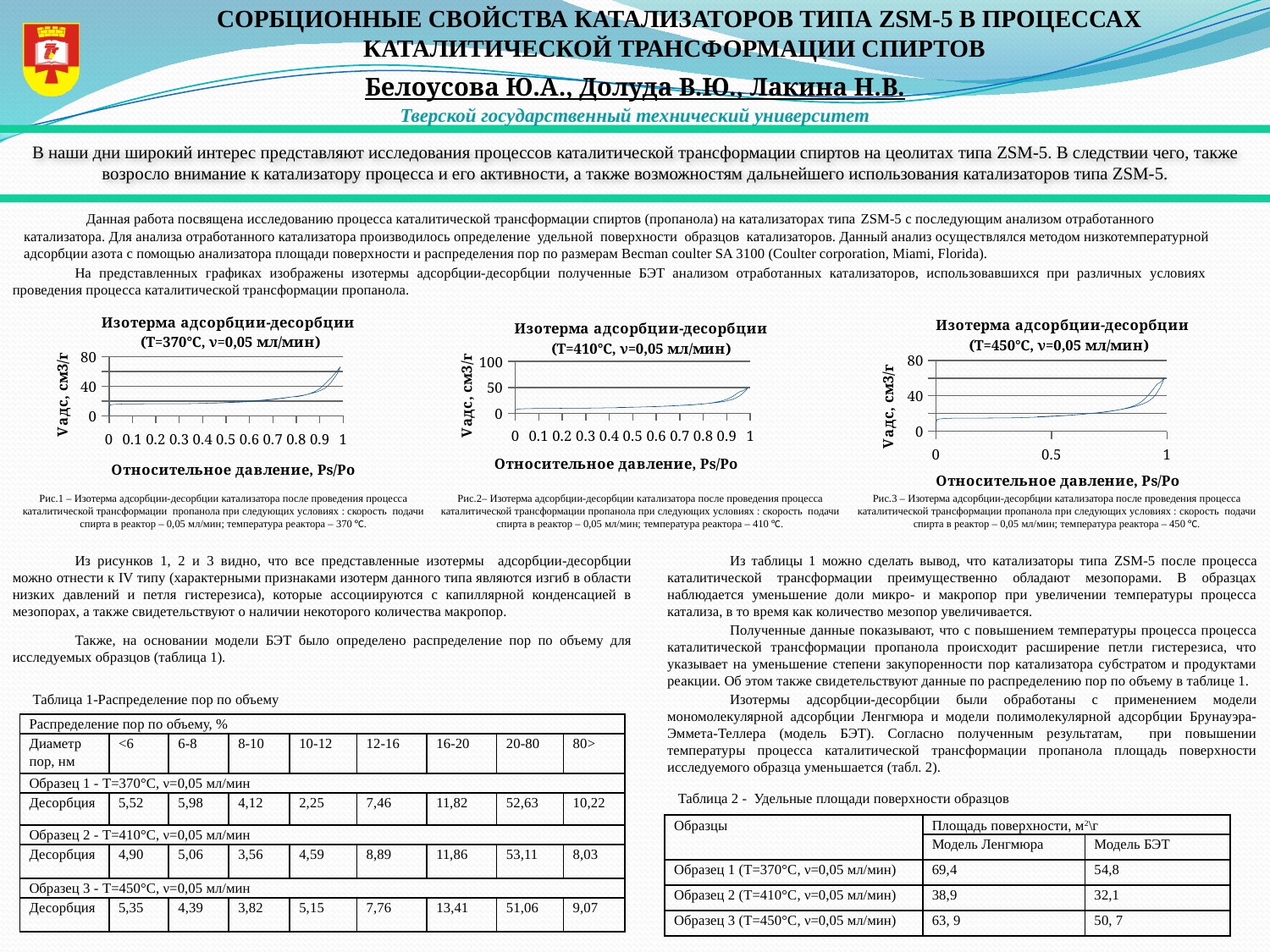
In the chart titled "Изотерма адсорбции-десорбции (T=450°C, v=0,05 мл/мин)", is the value at Ps/Po = 1 greater or less than 40? greater In the chart titled "Изотерма адсорбции-десорбции (T=450°C, v=0,05 мл/мин)", is the value at Ps/Po = 0.5 greater or less than 40? less What kind of chart is the chart titled "Изотерма адсорбции-десорбции (T=370°C, v=0,05 мл/мин)"? line chart In the chart titled "Изотерма адсорбции-десорбции (T=410°C, v=0,05 мл/мин)", do the values rise or fall as the relative pressure Ps/Po increases? rise In the chart titled "Изотерма адсорбции-десорбции (T=450°C, v=0,05 мл/мин)", do the values rise or fall along the x axis? rise What is the y-axis title of the chart titled "Изотерма адсорбции-десорбции (T=410°C, v=0,05 мл/мин)"? Vадс, см3/г In the chart titled "Изотерма адсорбции-десорбции (T=370°C, v=0,05 мл/мин)", is the value at Ps/Po = 1 greater or less than 40? greater How many charts are shown on the slide? 3 What is the x-axis title of the chart titled "Изотерма адсорбции-десорбции (T=370°C, v=0,05 мл/мин)"? Относительное давление, Ps/Po